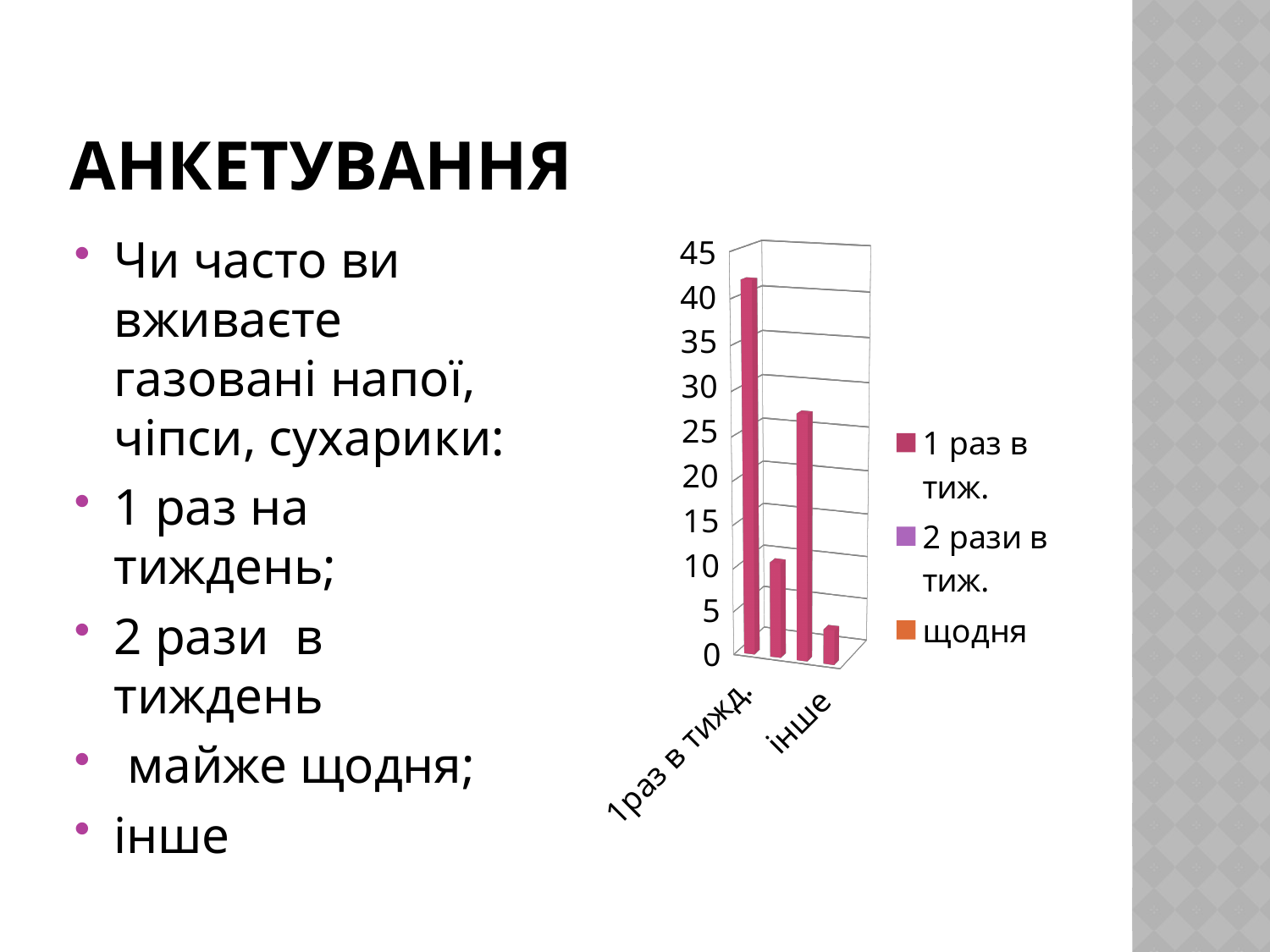
Is the value of the second bar greater or less than 15? less Which bar is the tallest in the chart? the first (leftmost) bar Is the value of the leftmost bar greater or less than 35? greater How many bars are plotted in the chart? 4 Is the value of the rightmost bar greater or less than 5? less What is the third entry in the chart legend? щодня What kind of chart is shown on the slide? bar chart Which is larger, the second bar or the third bar? the third bar How many series does the chart legend list? 3 Which bar is the shortest in the chart? the fourth (rightmost) bar What is the highest value shown on the vertical axis? 45